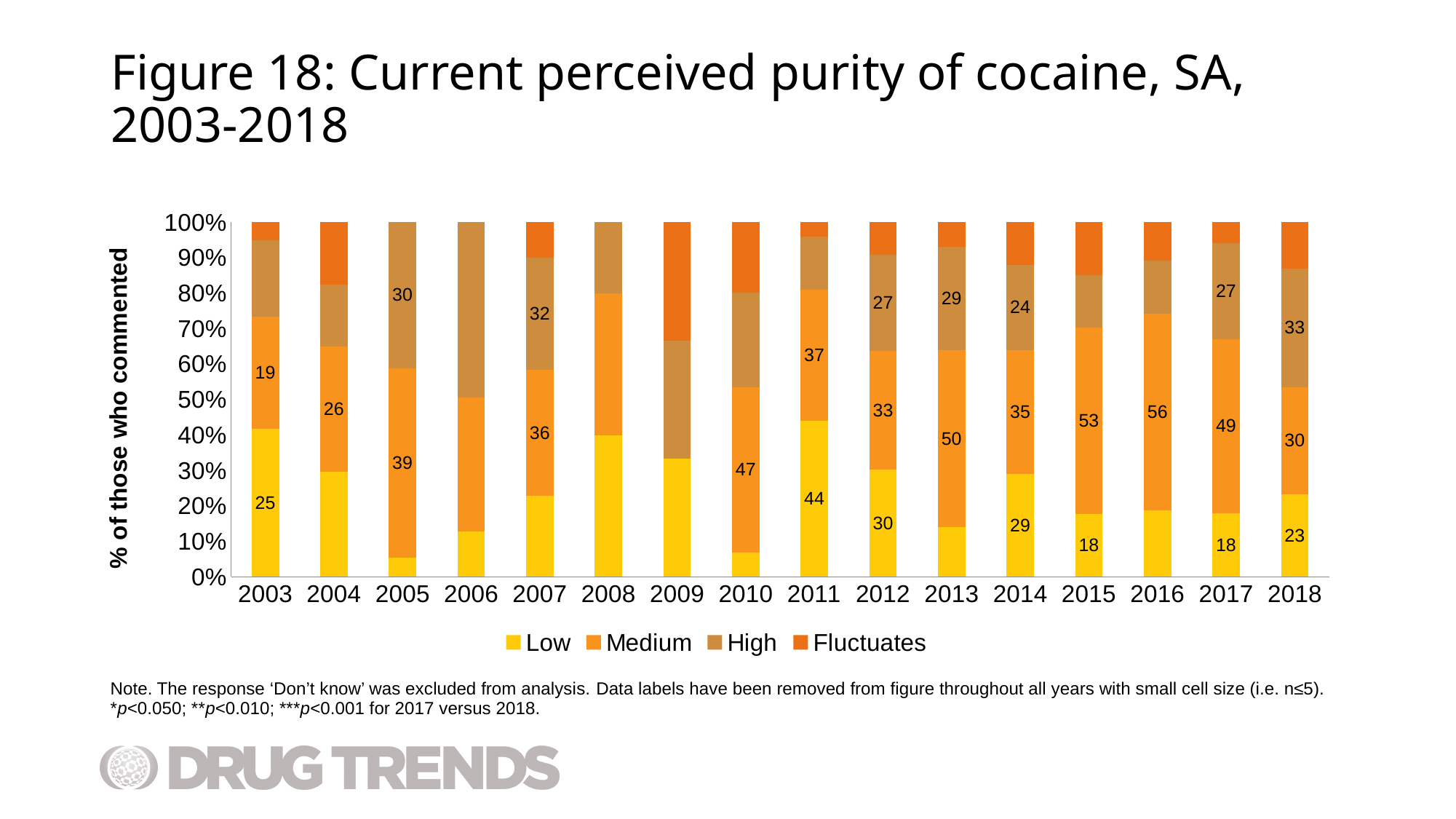
What is the data label on the High segment for 2018? 33 Which year has the larger Low data label, 2011 or 2012? 2011 What is the data label on the Low segment for 2011? 44 Is the Low segment for 2005 greater or less than 10%? less How many series does the legend list? 4 What is the difference between the High and Medium data labels for 2018? 3 What is the data label on the Medium segment for 2016? 56 How many years are shown on the x axis? 16 Which year has the largest Medium segment? 2016 What is the data label on the Medium segment for 2013? 50 What kind of chart is shown on the slide? Stacked bar chart What are the four legend entries of the chart? Low, Medium, High, Fluctuates